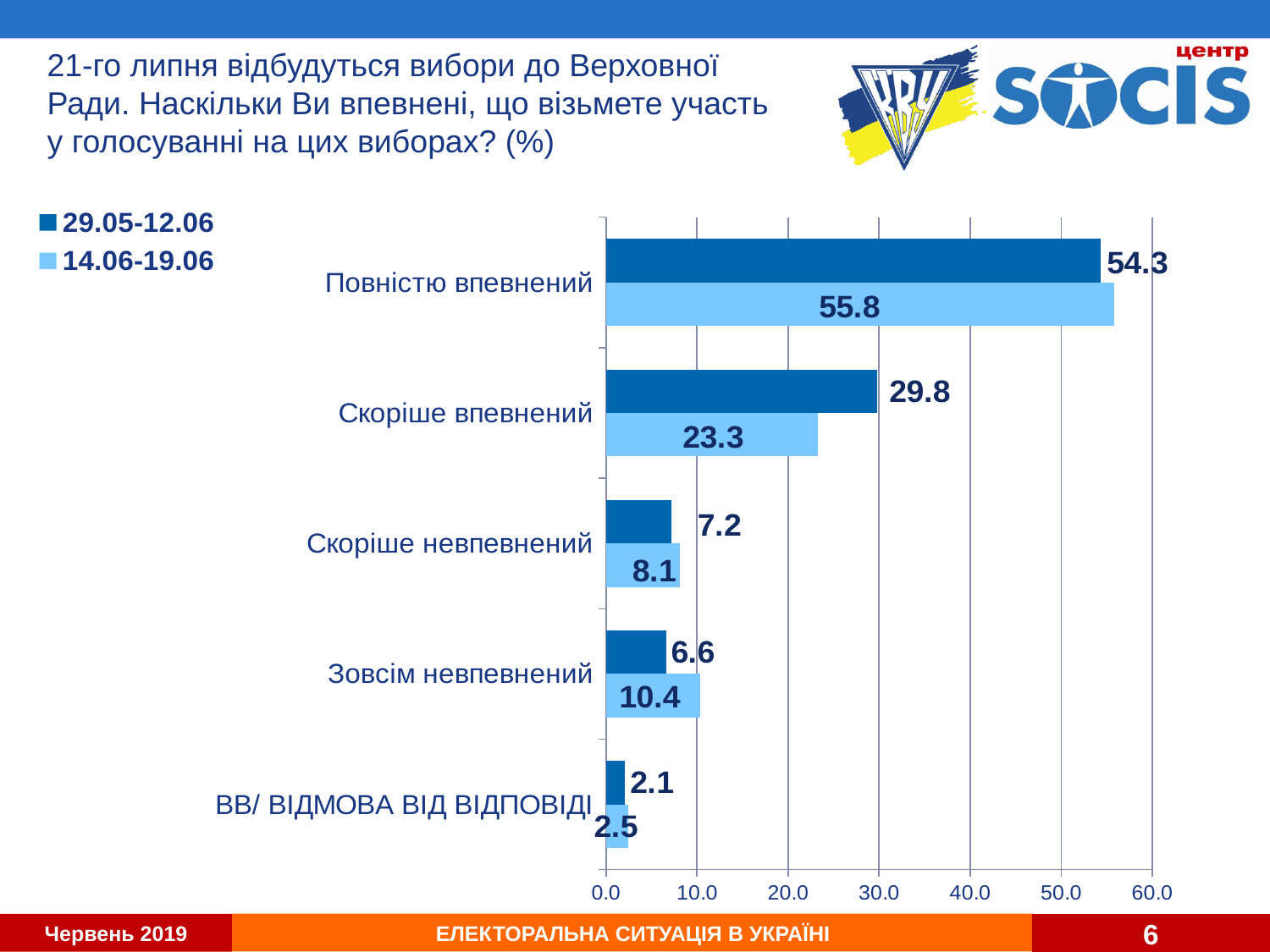
Is the 14.06-19.06 value for "Повністю впевнений" greater or less than 50.0? greater What kind of chart is shown on the slide? Bar chart What is the difference between the 29.05-12.06 and 14.06-19.06 values for "Скоріше впевнений"? 6.5 For "Зовсім невпевнений", which series has the larger value: 29.05-12.06 or 14.06-19.06? 14.06-19.06 What is the value for "Скоріше впевнений" in the 29.05-12.06 series? 29.8 What is the value for "Зовсім невпевнений" in the 14.06-19.06 series? 10.4 How many categories are shown on the chart? 5 How many series does the legend list? 2 Which category has the highest value in the 29.05-12.06 series? Повністю впевнений What is the value for "Повністю впевнений" in the 14.06-19.06 series? 55.8 What is the value for "ВВ/ ВІДМОВА ВІД ВІДПОВІДІ" in the 29.05-12.06 series? 2.1 Which category has the lowest value in the 14.06-19.06 series? ВВ/ ВІДМОВА ВІД ВІДПОВІДІ